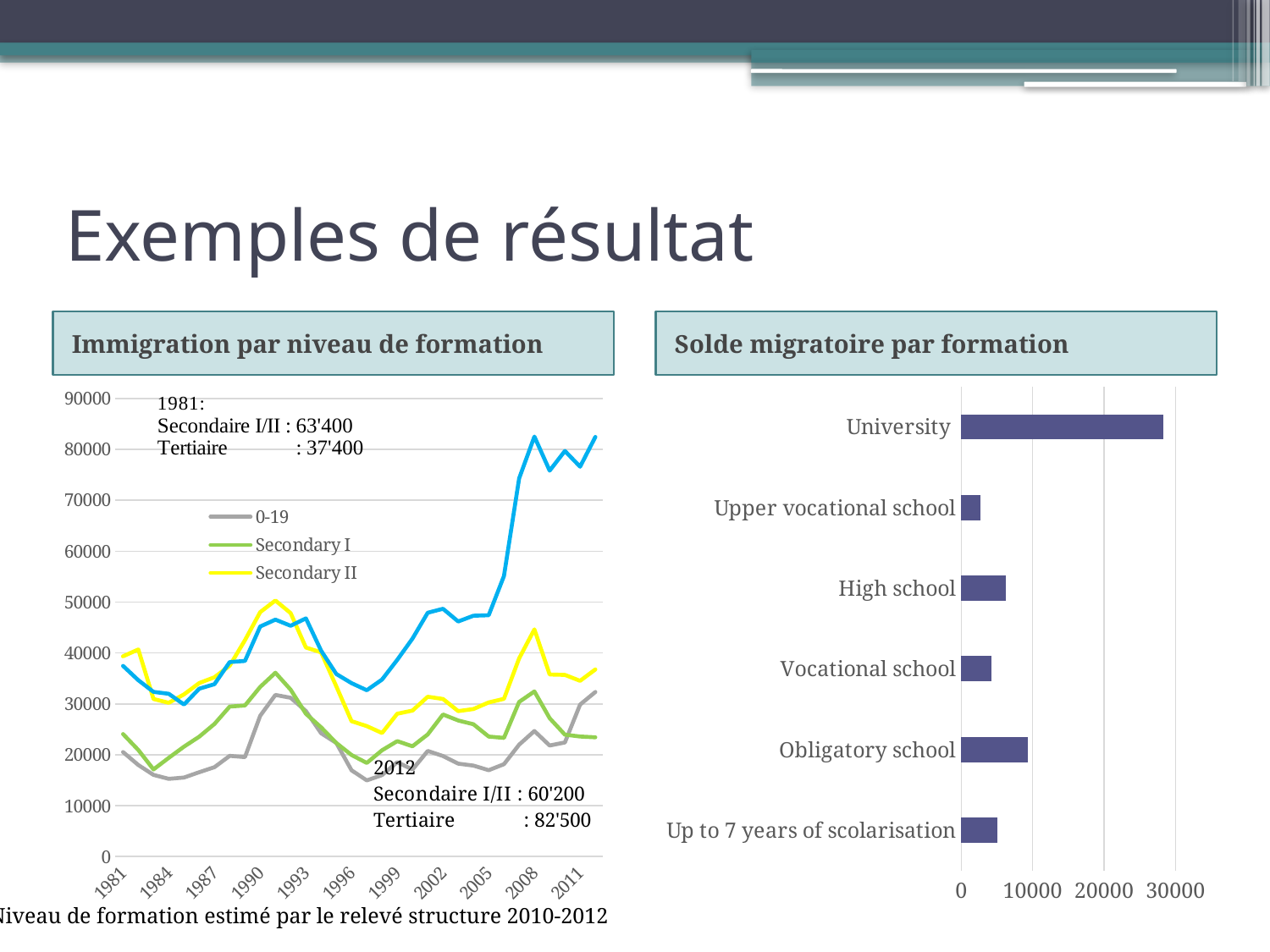
What kind of chart is 'Solde migratoire par formation'? bar chart In the 'Solde migratoire par formation' chart, is the value for University greater or less than 20000? greater According to the annotation on the 'Immigration par niveau de formation' chart, what is the Tertiaire value for 2012? 82'500 In the 'Solde migratoire par formation' chart, which is larger: Obligatory school or High school? Obligatory school In the 'Solde migratoire par formation' chart, which category has the highest value? University In the 'Immigration par niveau de formation' chart, which is higher in 2011: Secondary I or Secondary II? Secondary II How many categories are shown in the 'Solde migratoire par formation' chart? 6 How many series does the legend of the 'Immigration par niveau de formation' chart list? 3 According to the annotation on the 'Immigration par niveau de formation' chart, what is the Secondaire I/II value for 1981? 63'400 In the 'Immigration par niveau de formation' chart, does the Secondary II line rise or fall between 2008 and 2011? fall What kind of chart is 'Immigration par niveau de formation'? line chart